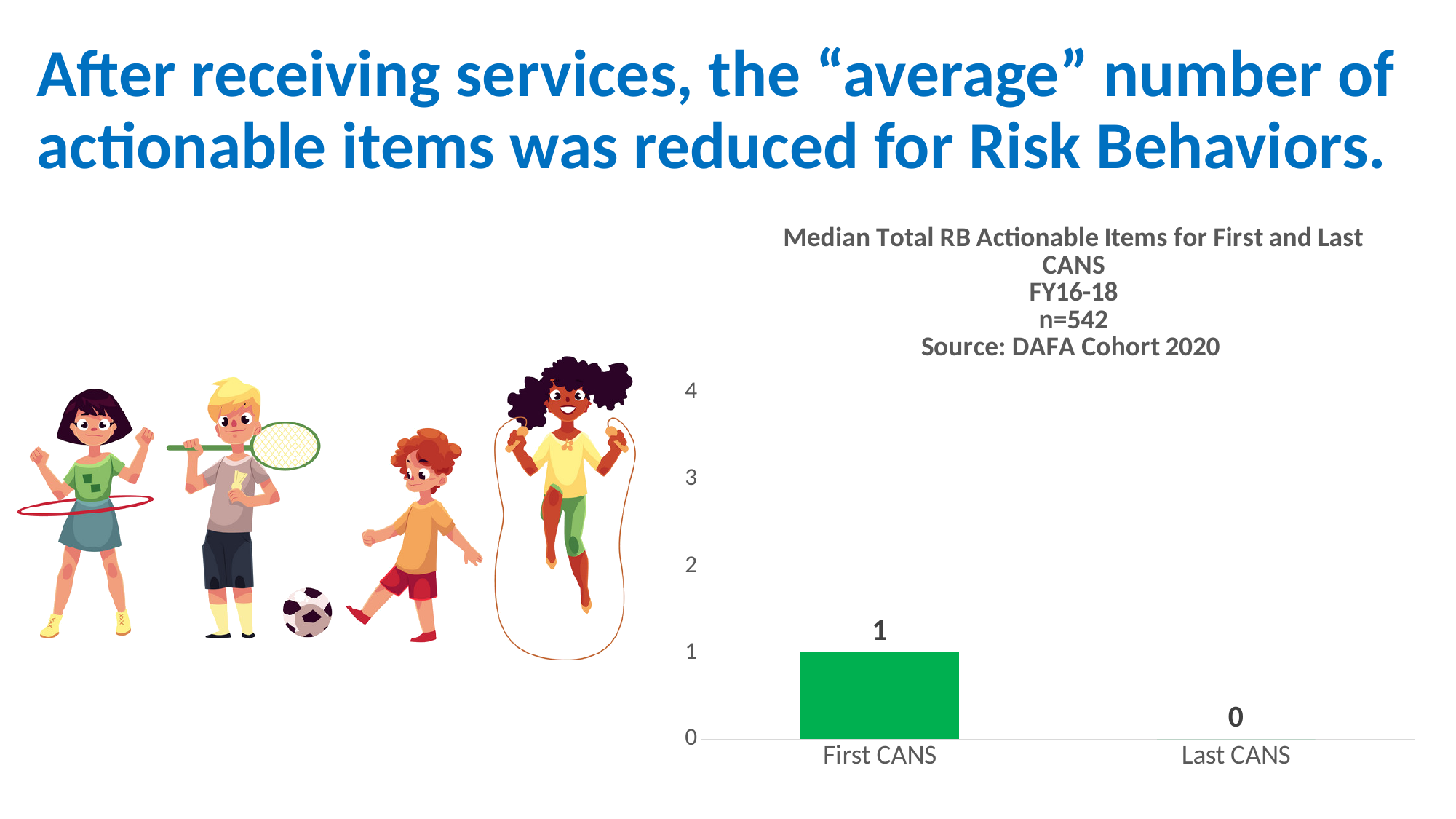
What kind of chart is shown on the slide? Bar chart What is the sample size (n) stated in the chart title? n=542 What is the median total RB actionable items value for Last CANS? 0 Which category has the highest value on the chart? First CANS Which category has the lowest value on the chart? Last CANS How many categories are shown on the x axis of the chart? 2 Which category has the higher value, First CANS or Last CANS? First CANS What is the difference between the First CANS and Last CANS values? 1 What is the median total RB actionable items value for First CANS? 1 Do the values rise or fall from First CANS to Last CANS? Fall What is the highest value shown on the chart's vertical axis? 4 Is the value for First CANS greater or less than 2? less